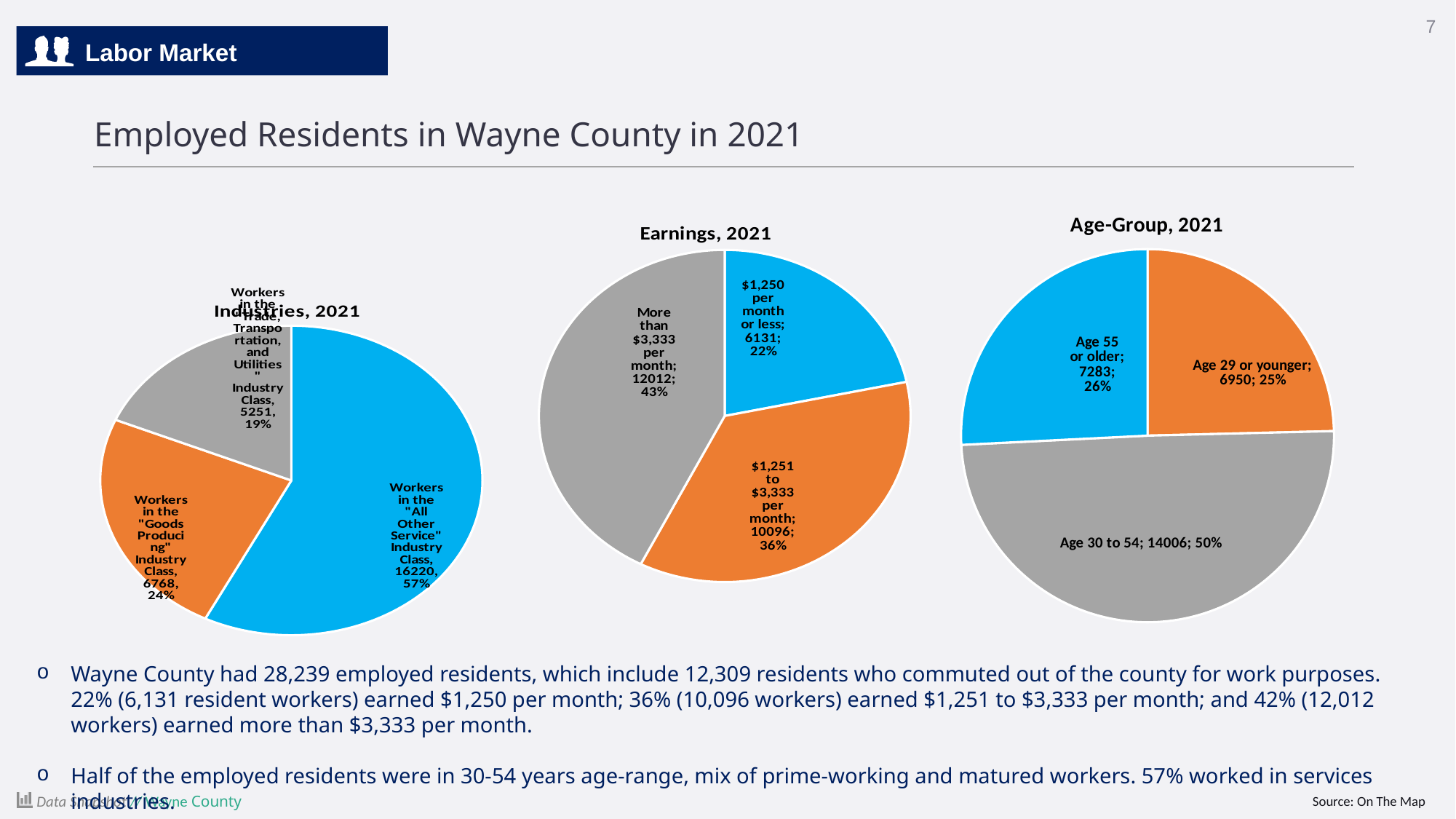
In the Earnings, 2021 chart, how many workers earned $1,251 to $3,333 per month? 10096 What type of chart is the Earnings, 2021 chart? Pie chart In the Industries, 2021 chart, which industry class has the smallest slice? Workers in the "Trade, Transportation, and Utilities" Industry Class In the Earnings, 2021 chart, what percentage of workers earned $1,250 per month or less? 22% In the Earnings, 2021 chart, what is the difference in workers between the "More than $3,333 per month" group and the "$1,250 per month or less" group? 5881 In the Industries, 2021 chart, what share of the pie is the "Goods Producing" Industry Class? 24% In the Industries, 2021 chart, how many workers are in the "All Other Service" Industry Class? 16220 How many slices does the Age-Group, 2021 pie chart have? 3 In the Earnings, 2021 chart, which earnings group has the largest slice? More than $3,333 per month In the Age-Group, 2021 chart, what share of the pie is Age 29 or younger? 25% In the Age-Group, 2021 chart, which is larger: Age 55 or older or Age 29 or younger? Age 55 or older In the Age-Group, 2021 chart, how many employed residents are Age 30 to 54? 14006